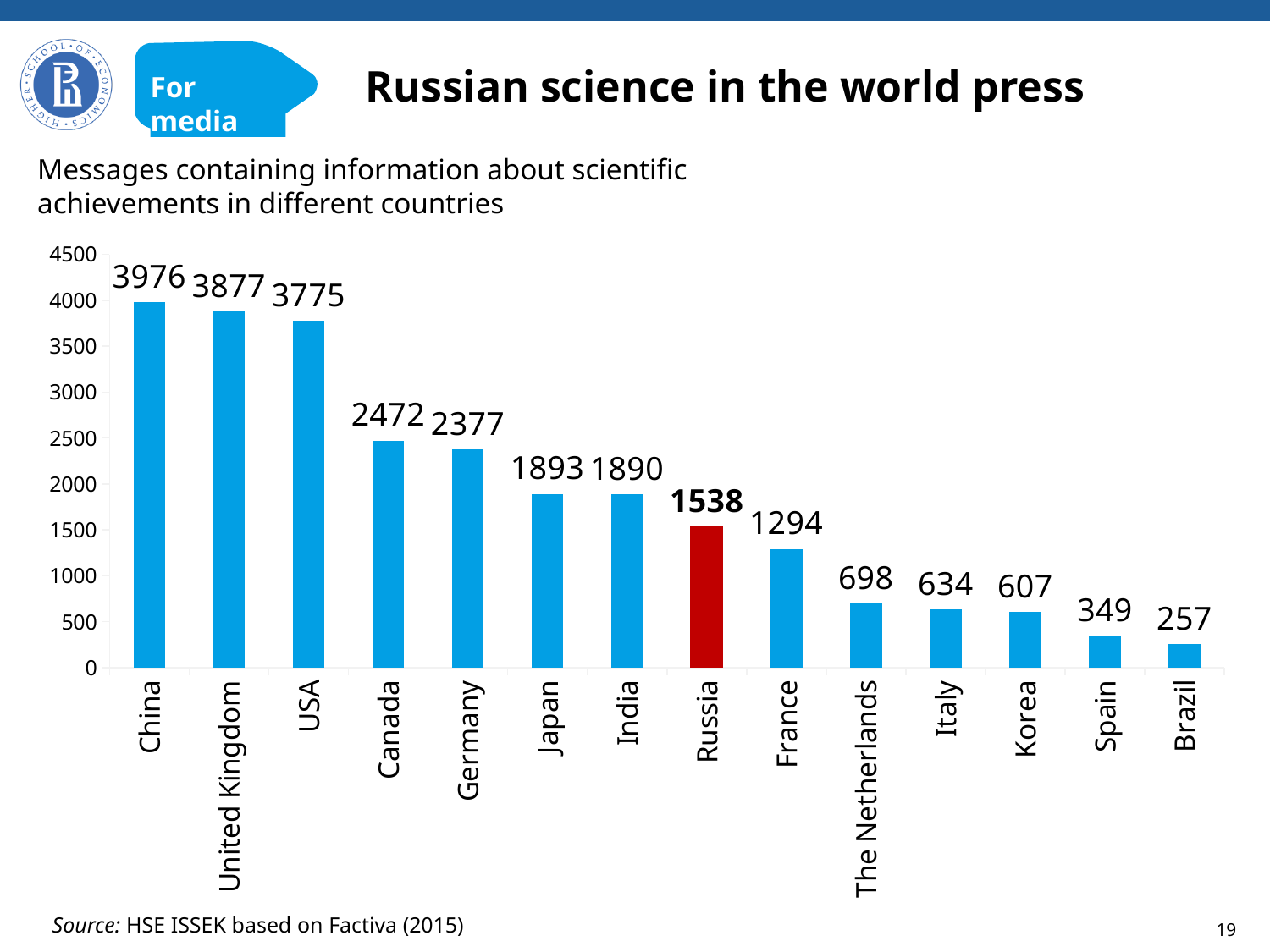
What is the difference between the values for China and the United Kingdom? 99 How many countries are shown in the chart? 14 Which is larger, the value for Germany or the value for Japan? Germany Which country's bar is coloured red instead of blue? Russia Is the value for USA greater or less than 3500? greater What is the value for The Netherlands? 698 What is the value for Canada? 2472 Which country has the lowest value? Brazil What is the value for Russia? 1538 Which country has the highest value? China What is the difference between the values for Russia and France? 244 What kind of chart is shown on the slide? Bar chart